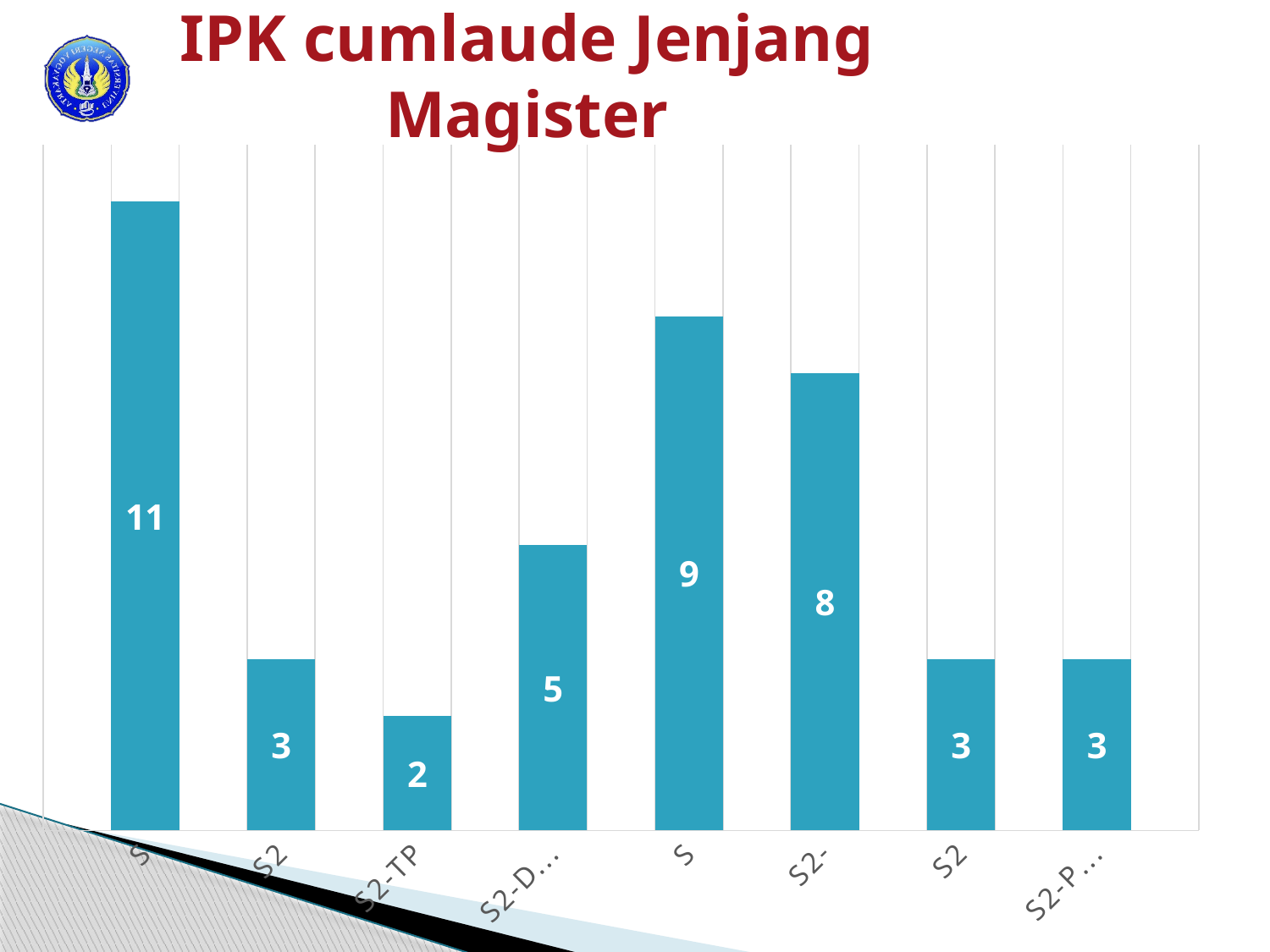
What is the difference between the highest and lowest values in the chart? 9 What is the title of the chart? IPK cumlaude Jenjang Magister What is the highest value shown in the chart? 11 What is the lowest value shown in the chart? 2 What is the value of the first bar from the left? 11 How many bars in the chart have a value of 3? 3 Which is larger, the fifth bar from the left or the sixth bar from the left? the fifth bar (9) What type of chart is shown on the slide? bar chart What is the value of the fifth bar from the left? 9 What is the difference between the fifth bar (9) and the sixth bar (8)? 1 How many bars are plotted in the chart? 8 What is the value for S2-TP? 2